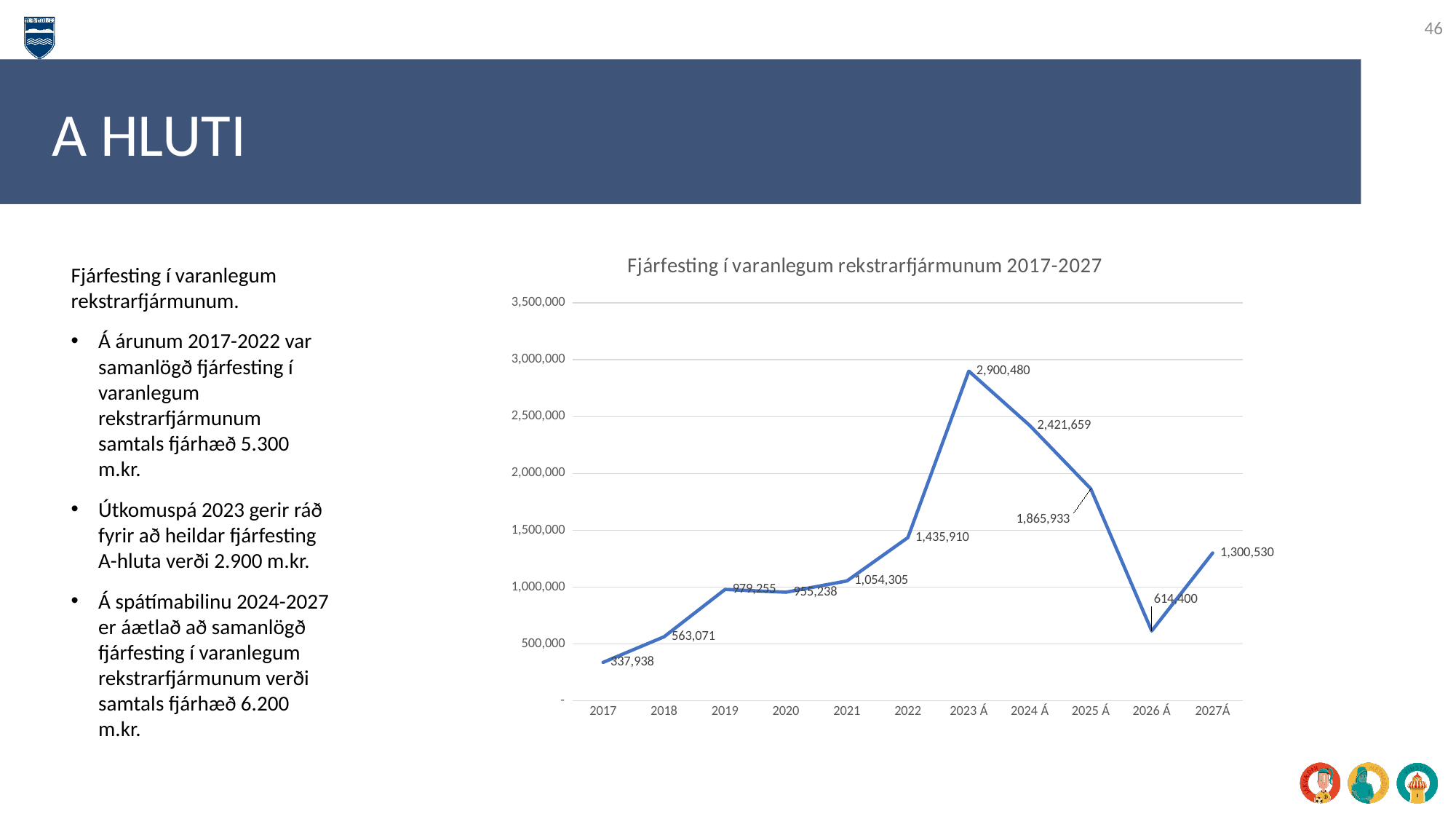
What is the value for 2023 Á? 2,900,480 Which year has the highest value? 2023 Á What is the difference between the values for 2023 Á and 2024 Á? 478,821 What type of chart is shown on the slide? line chart Which year has the lowest value? 2017 What is the value for 2017? 337,938 What is the value for 2027Á? 1,300,530 Is the value for 2026 Á greater or less than 1,000,000? less Which is larger, the value for 2025 Á or the value for 2027Á? 2025 Á How many data points are plotted on the chart? 11 What is the title of the chart? Fjárfesting í varanlegum rekstrarfjármunum 2017-2027 What is the value for 2026 Á? 614,400